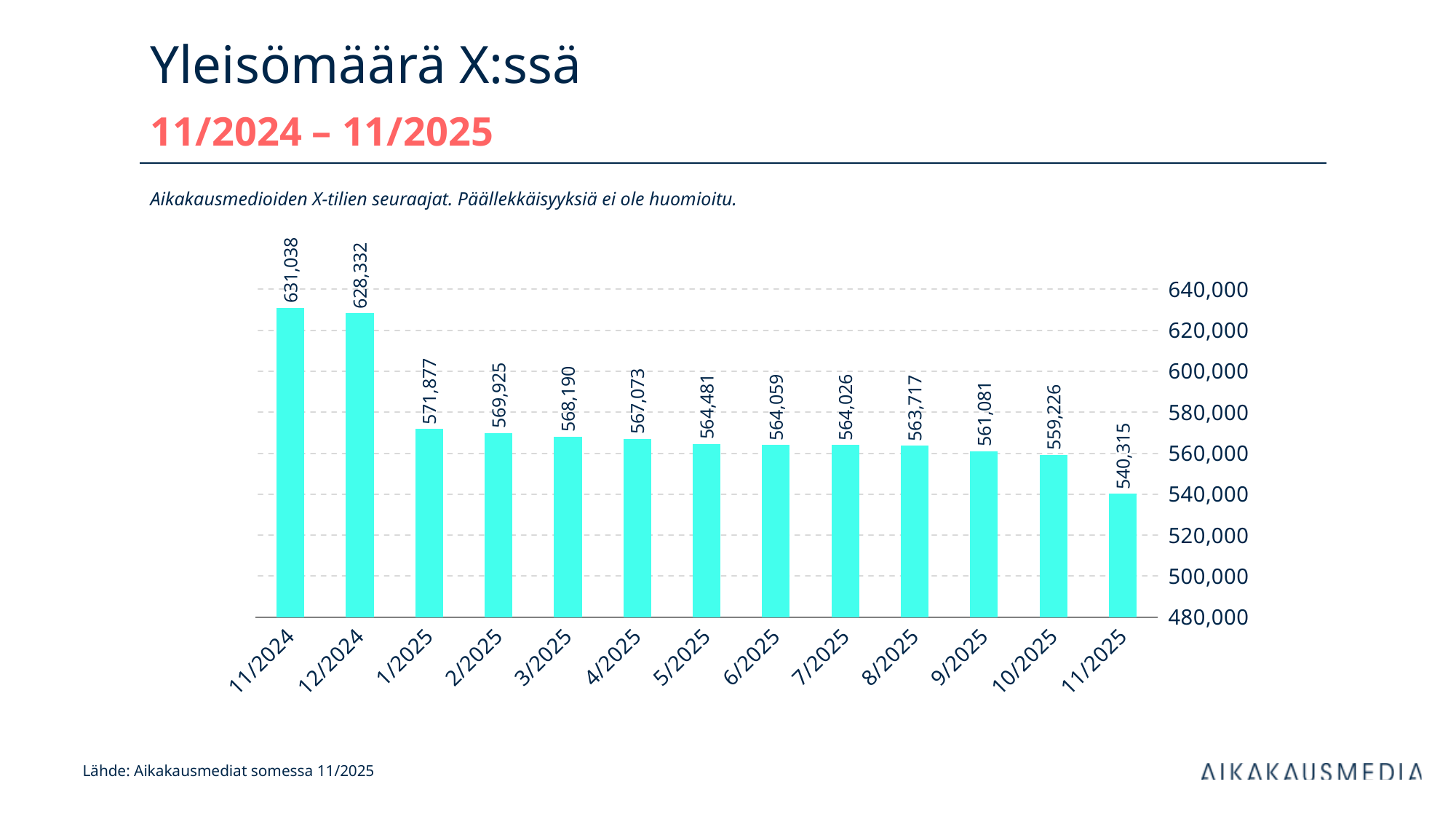
Which month has the lowest value? 11/2025 What is the value for 11/2025? 540,315 Which is larger, the value for 12/2024 or the value for 1/2025? 12/2024 Which month has the highest value? 11/2024 How many months are shown on the x axis? 13 What kind of chart is shown on the slide? bar chart What is the value for 11/2024? 631,038 What is the difference between the values for 11/2024 and 11/2025? 90,723 What is the difference between the values for 10/2025 and 11/2025? 18,911 Do the values generally rise or fall from 11/2024 to 11/2025? fall Is the value for 9/2025 greater or less than 580,000? less What is the value for 5/2025? 564,481